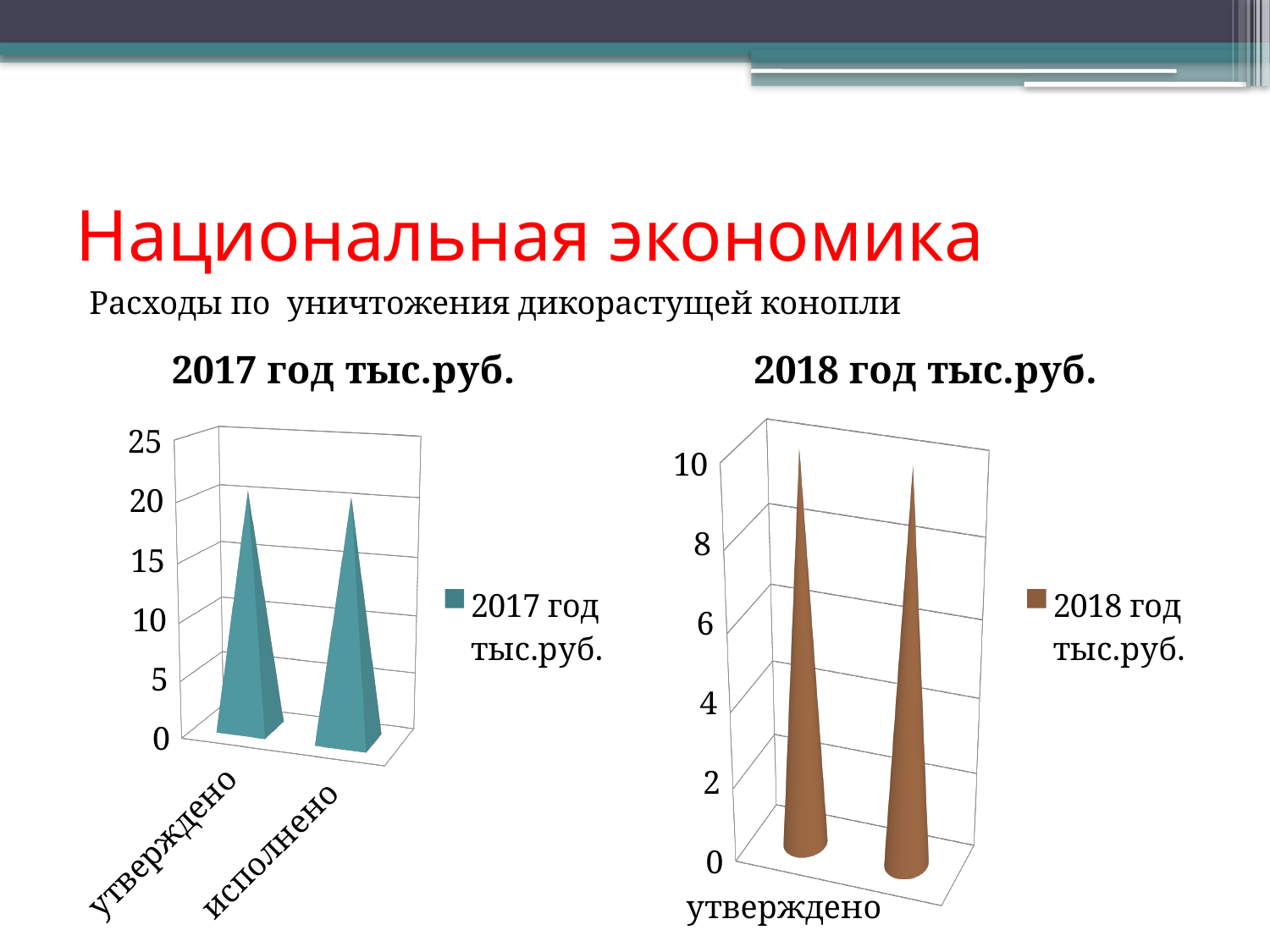
How many bars are plotted in the chart titled "2018 год тыс.руб."? 2 What kind of chart is the chart titled "2017 год тыс.руб."? bar chart In the chart titled "2017 год тыс.руб.", is the value for исполнено greater or less than 25? less In the chart titled "2018 год тыс.руб.", is the value for утверждено greater or less than 6? greater In the chart titled "2017 год тыс.руб.", is the value for исполнено greater or less than 10? greater How many series does the legend of the chart titled "2017 год тыс.руб." list? 1 How many categories are shown on the x axis of the chart titled "2017 год тыс.руб."? 2 How many series does the legend of the chart titled "2018 год тыс.руб." list? 1 What is the legend entry of the chart on the right side of the slide? 2018 год тыс.руб. What is the highest value shown on the vertical axis of the chart titled "2018 год тыс.руб."? 10